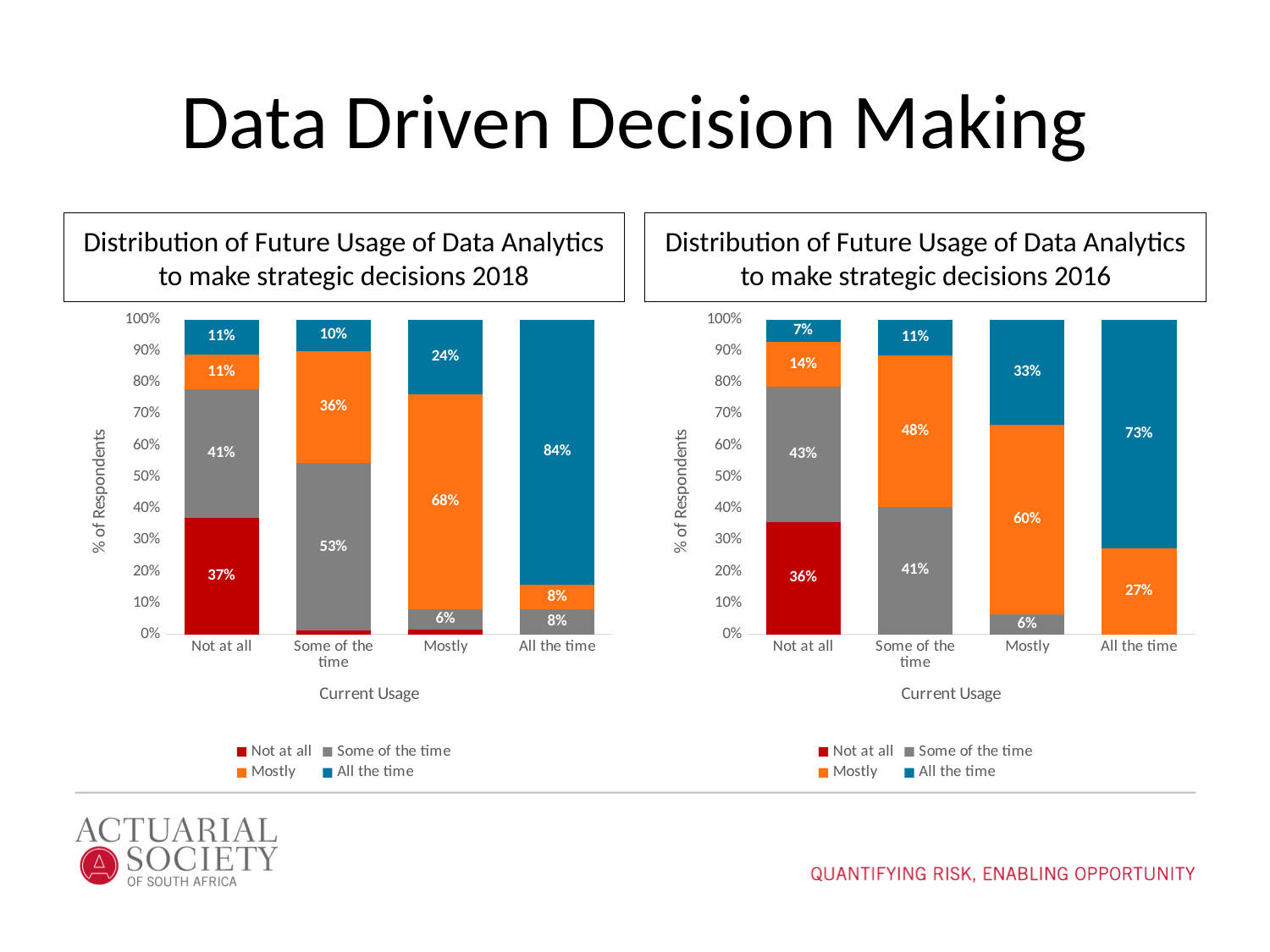
In the 2016 chart, which is larger: the 'All the time' segment for 'Mostly' current usage or the 'All the time' segment for 'Some of the time' current usage? Mostly What is the y-axis label of the 2016 chart? % of Respondents In the 2018 chart, what is the 'Not at all' share for the 'Not at all' current usage category? 37% In the 2018 chart, what is the difference between the 'Mostly' segment for 'Mostly' current usage (68%) and the 'Mostly' segment for 'Some of the time' current usage (36%)? 32% In the 2016 chart, what is the 'Some of the time' share for the 'Some of the time' current usage category? 41% What type of chart is the 2018 chart? Stacked bar chart How many current usage categories are shown on the x axis of the 2018 chart? 4 In the 2016 chart, which current usage category has the smallest 'Some of the time' segment? All the time In the 2018 chart, what percentage of respondents who currently use data analytics 'All the time' expect to use it 'All the time' in future? 84% In the 2018 chart, which current usage category has the largest 'All the time' segment? All the time In the 2016 chart, what is the 'Mostly' share for the 'Mostly' current usage category? 60% How many series does the legend of the 2016 chart list? 4